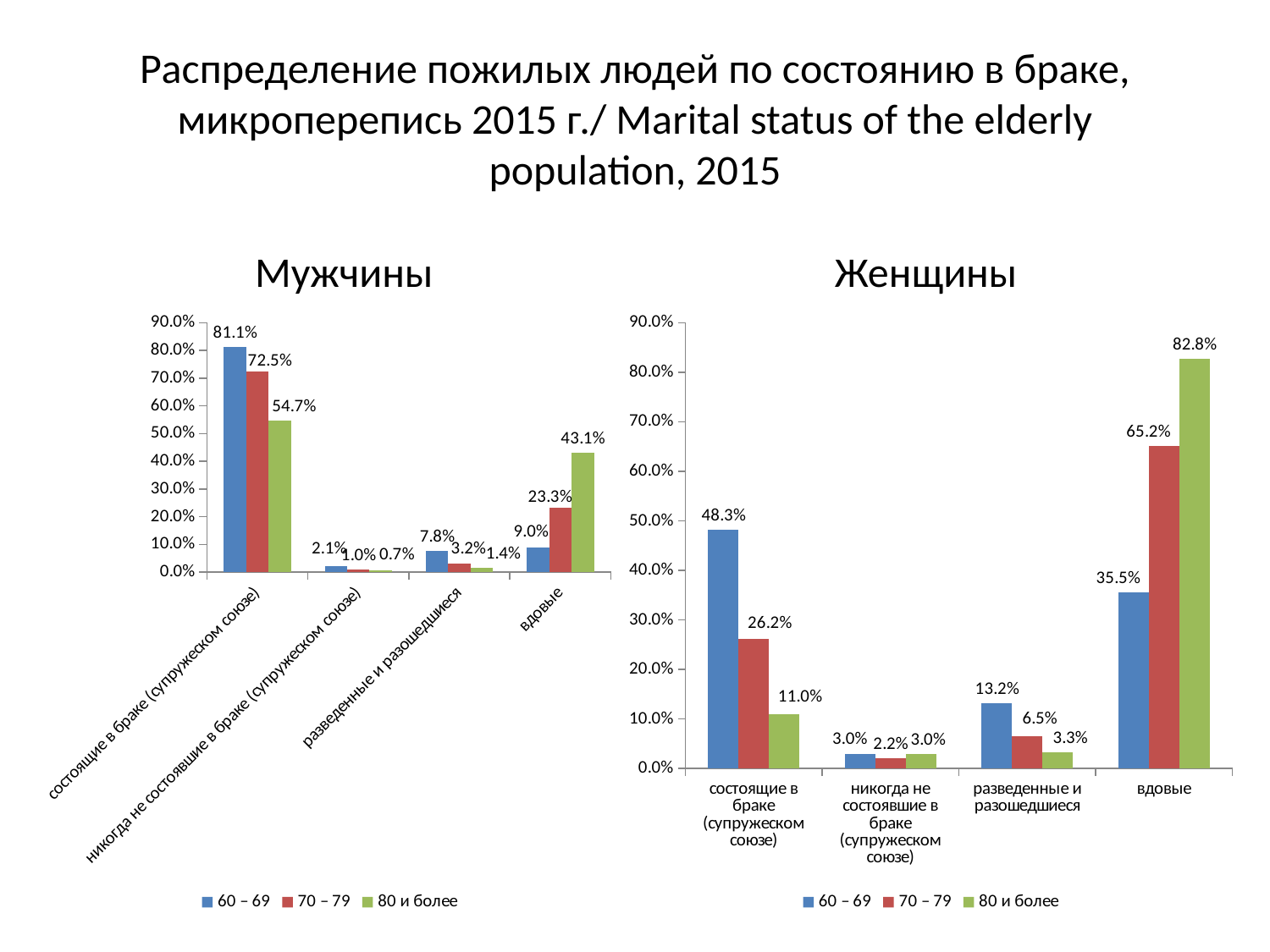
In the Женщины chart, what is the value for the 70 – 79 series in the разведенные и разошедшиеся category? 6.5% In the Мужчины chart, what is the value for the 60 – 69 series in the состоящие в браке (супружеском союзе) category? 81.1% How many categories are shown on the x axis of the Женщины chart? 4 In the Женщины chart, what is the difference between the 80 и более and 60 – 69 values in the вдовые category? 47.3% What kind of chart is the Мужчины chart? bar chart In the Женщины chart, which category has the lowest value for the 60 – 69 series? никогда не состоявшие в браке (супружеском союзе) In the Женщины chart, what is the value for the 80 и более series in the вдовые category? 82.8% In the Женщины chart, is the value for the 70 – 79 series in the вдовые category greater or less than 60.0%? greater In the Мужчины chart, which is larger in the вдовые category: the 70 – 79 value or the 80 и более value? 80 и более In the Мужчины chart, which category has the highest value for the 80 и более series? состоящие в браке (супружеском союзе) How many series does the legend of the Мужчины chart list? 3 In the Мужчины chart, what is the difference between the 60 – 69 and 80 и более values in the состоящие в браке (супружеском союзе) category? 26.4%